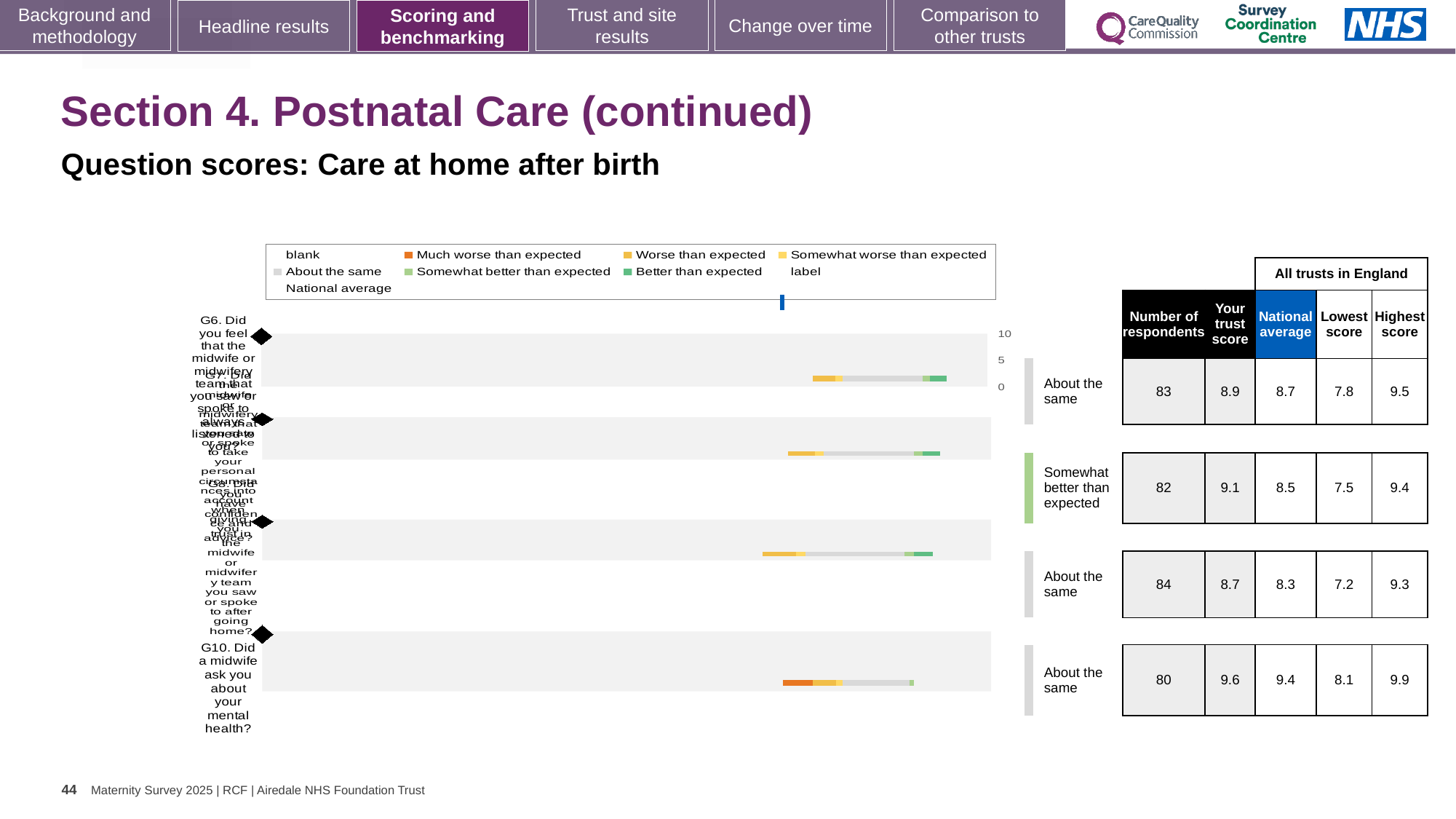
What is the 'Your trust score' for G10 (Did a midwife ask you about your mental health?)? 9.6 What is the number of respondents for G6 (the first row)? 83 How many rows are rated 'About the same'? 3 Which row has the highest 'Your trust score'? G10 (mental health), 9.6 For G10, what is the difference between the trust score and the national average? 0.2 Which row has the lowest national average? The third row, 8.3 What is the highest score across all trusts in England for G10? 9.9 For G6, is the trust score or the national average higher? Trust score (8.9) What benchmark category is given for the second row? Somewhat better than expected What kind of chart is shown on the slide? Bar chart How many survey questions (rows) are plotted in the chart? 4 What is the lowest score across all trusts in England for G6? 7.8